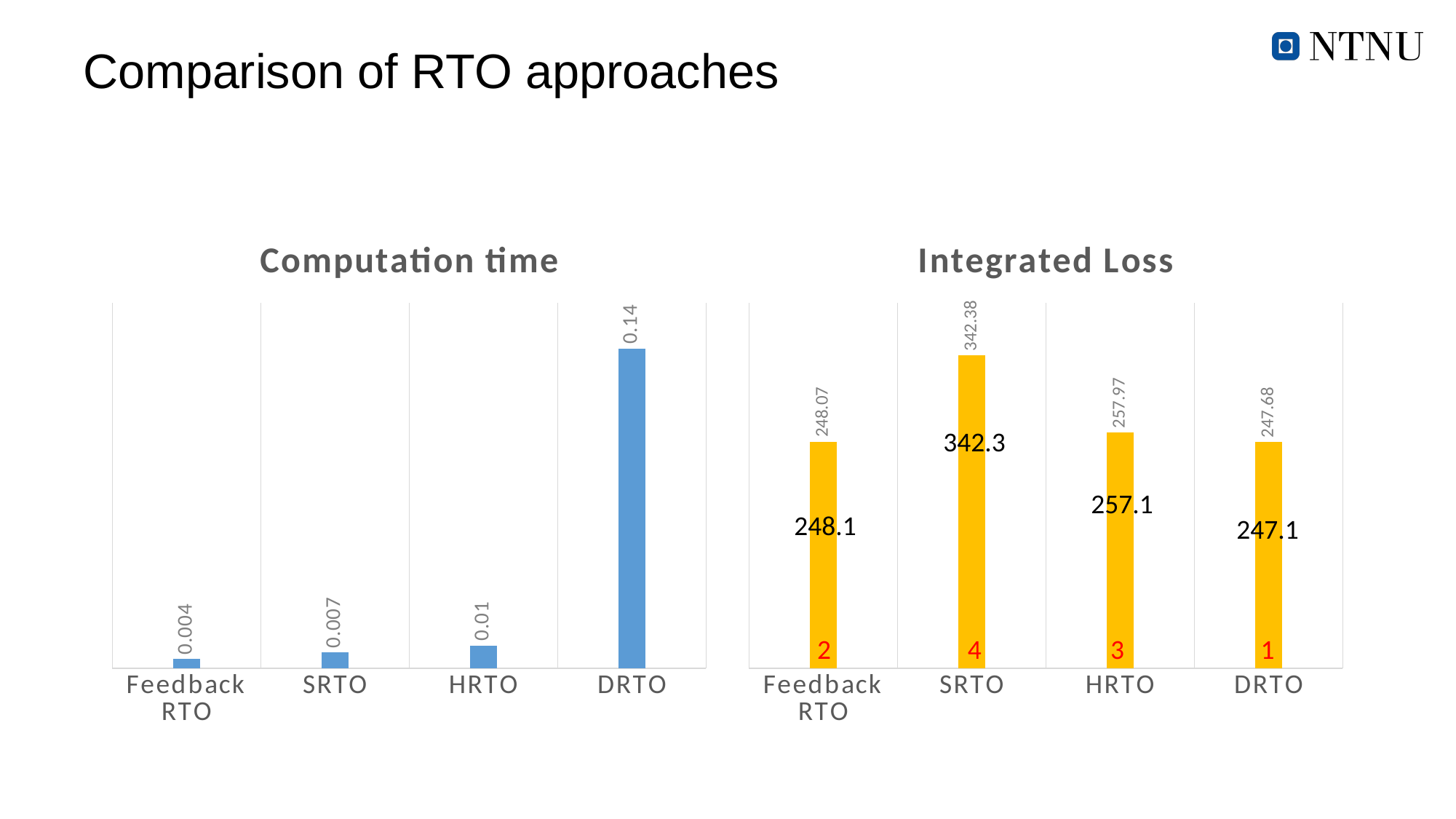
How many approaches are compared in the Integrated Loss chart? 4 In the Integrated Loss chart, is the value for HRTO larger or smaller than the value for Feedback RTO? larger In the Computation time chart, which approach has the lowest computation time? Feedback RTO In the Computation time chart, what is the value for Feedback RTO? 0.004 In the Computation time chart, what is the difference between the values for DRTO and HRTO? 0.13 In the Computation time chart, what is the value for DRTO? 0.14 What type of chart is the Computation time chart? bar chart In the Computation time chart, which approach has the highest computation time? DRTO In the Integrated Loss chart, which approach has the highest integrated loss? SRTO In the Integrated Loss chart, what value does the data label above the DRTO bar show? 247.68 In the Integrated Loss chart, what value does the data label above the SRTO bar show? 342.38 In the Computation time chart, what is the value for SRTO? 0.007